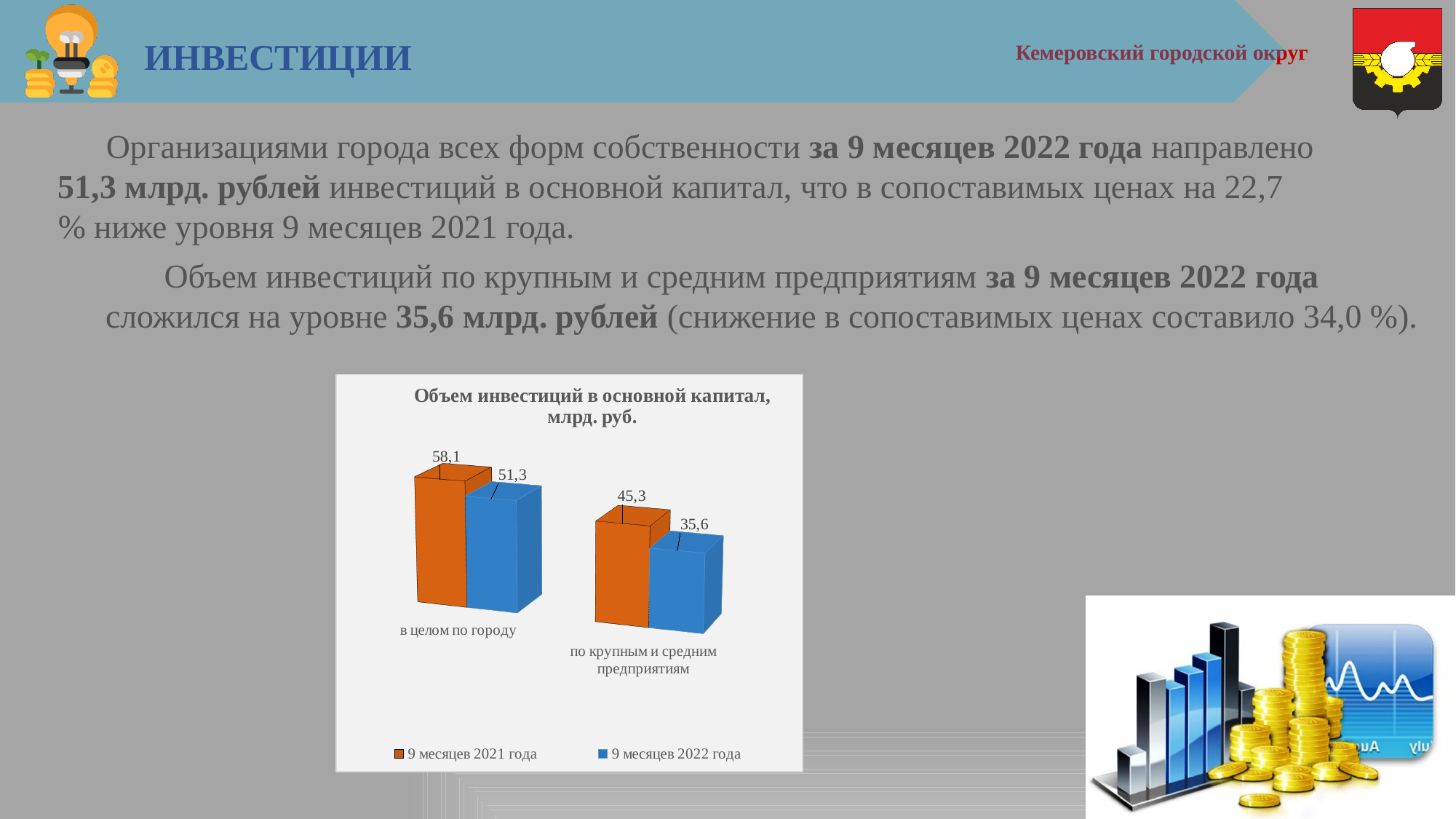
Which bar has the lowest value on the chart? по крупным и средним предприятиям, 9 месяцев 2022 года What is the value for "по крупным и средним предприятиям" in the "9 месяцев 2022 года" series? 35,6 How many categories are shown on the x axis of the chart? 2 What is the difference between the 2021 and 2022 values for "в целом по городу"? 6,8 For "по крупным и средним предприятиям", which series is larger: "9 месяцев 2021 года" or "9 месяцев 2022 года"? 9 месяцев 2021 года What is the value for "в целом по городу" in the "9 месяцев 2021 года" series? 58,1 What type of chart is shown on the slide? bar chart What is the difference between the 2021 and 2022 values for "по крупным и средним предприятиям"? 9,7 How many series does the legend list? 2 Which bar has the highest value on the chart? в целом по городу, 9 месяцев 2021 года What is the value for "по крупным и средним предприятиям" in the "9 месяцев 2021 года" series? 45,3 What is the value for "в целом по городу" in the "9 месяцев 2022 года" series? 51,3